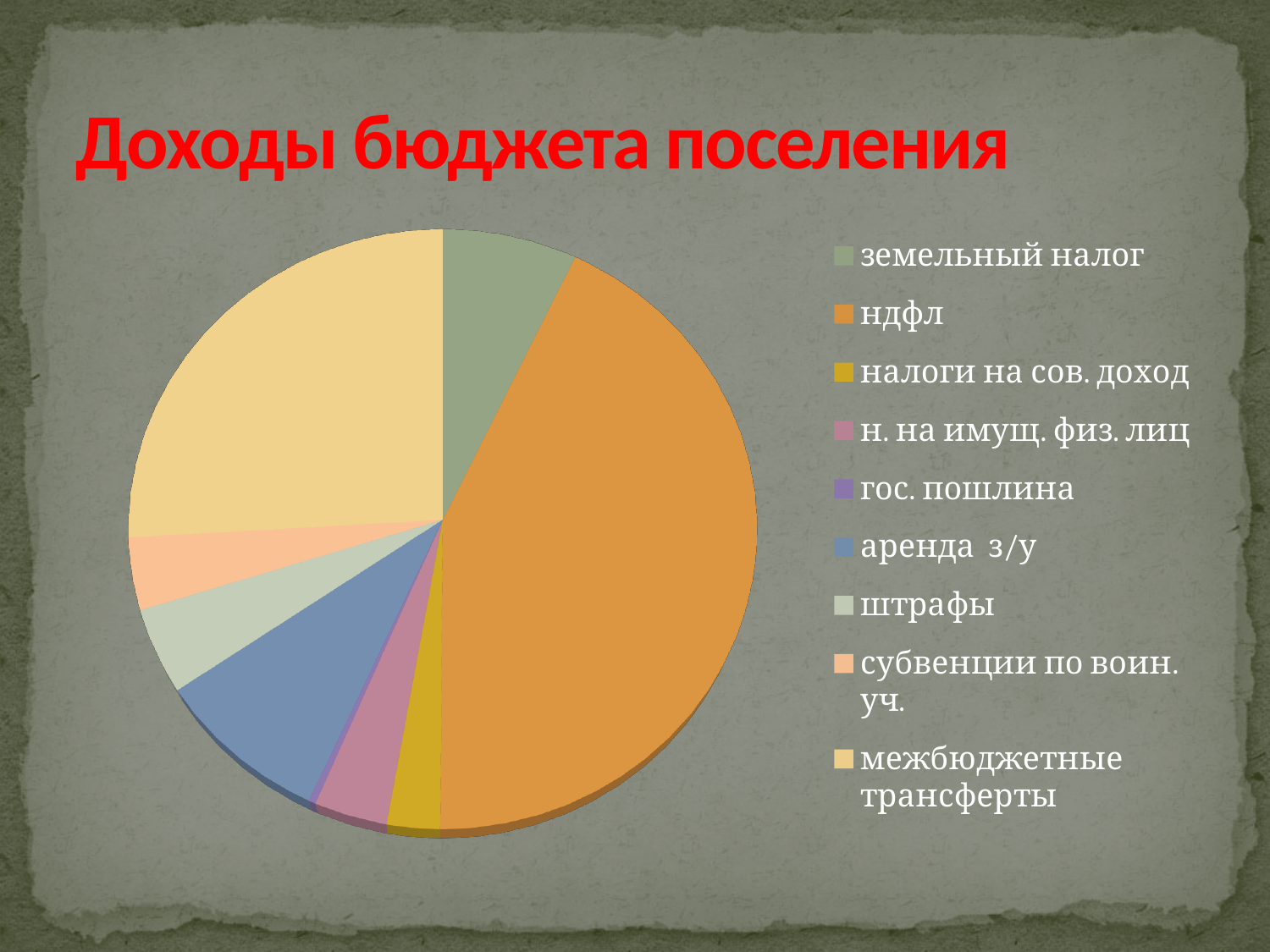
Which slice is larger: межбюджетные трансферты or земельный налог? межбюджетные трансферты What colour is the slice for ндфл in the pie chart? orange Which slice is larger: ндфл or межбюджетные трансферты? ндфл Which category has the smallest slice of the pie? гос. пошлина What kind of chart is shown on the slide? pie chart Which category has the largest slice of the pie? ндфл Which slice is larger: аренда з/у or налоги на сов. доход? аренда з/у Which category is the second largest slice of the pie? межбюджетные трансферты What is the title of the chart on the slide? Доходы бюджета поселения How many categories does the legend of the pie chart list? 9